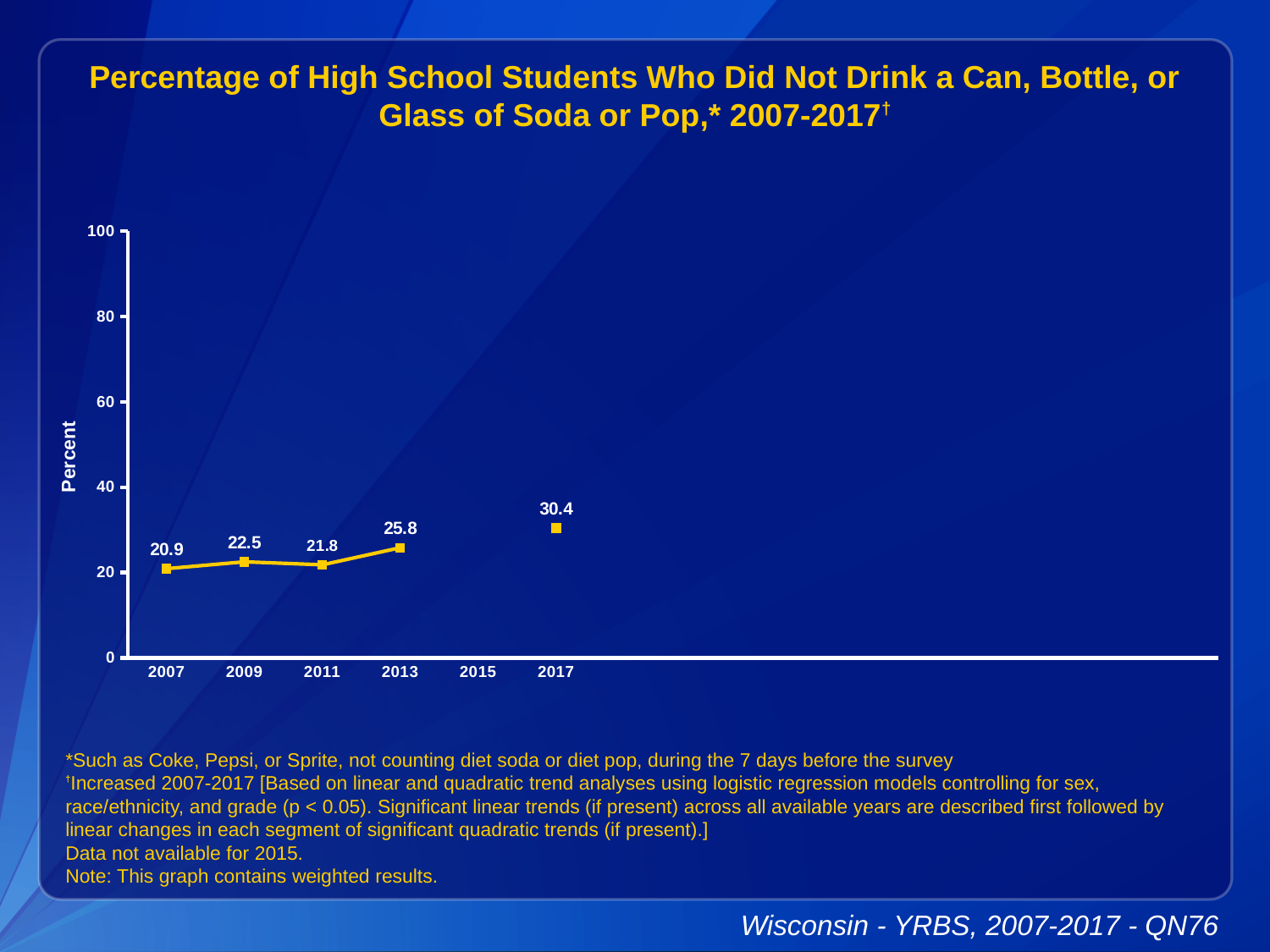
How many years have a plotted data point? 5 Which year has the highest value? 2017 Which year has the lowest value? 2007 What is the value for 2017? 30.4 What is the value for 2007? 20.9 Do the values generally rise or fall from 2007 to 2017? rise What is the value for 2013? 25.8 What is the difference between the values for 2017 and 2007? 9.5 Is the value for 2017 greater or less than 40? less Which is larger, the value for 2009 or the value for 2011? 2009 What kind of chart is this? line chart What is the label on the y axis? Percent